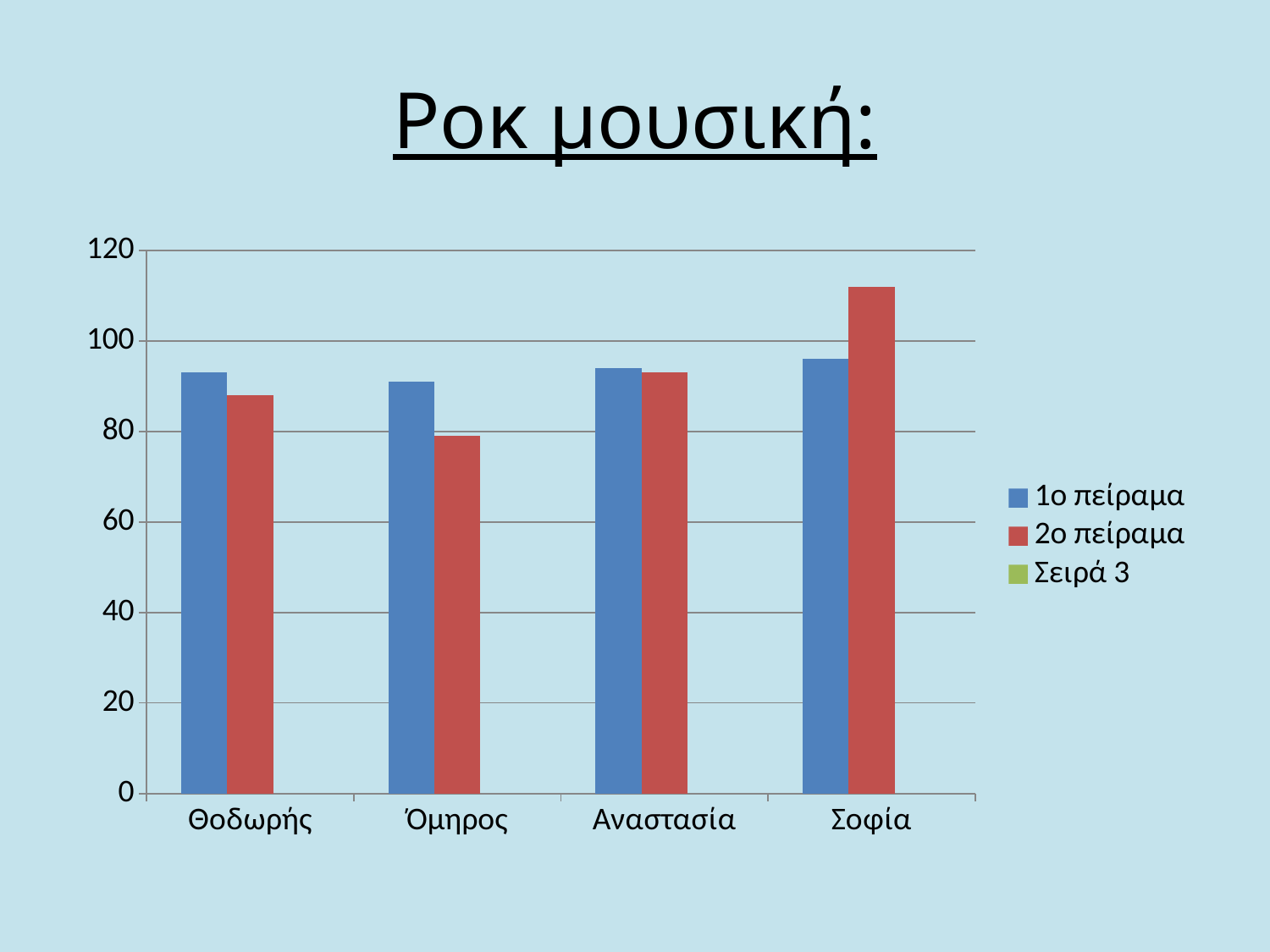
How many series does the legend list? 3 For Όμηρος, which is larger: 1ο πείραμα or 2ο πείραμα? 1ο πείραμα What is the title of the chart? Ροκ μουσική: Which category has the lowest value for 2ο πείραμα? Όμηρος What is the name of the third series in the legend? Σειρά 3 Is the 2ο πείραμα value for Σοφία greater or less than 100? greater How many categories are shown on the x axis? 4 Is the 1ο πείραμα value for Αναστασία greater or less than 100? less Which category has the highest value for 2ο πείραμα? Σοφία Is the 2ο πείραμα value for Όμηρος greater or less than 60? greater For Σοφία, which is larger: 1ο πείραμα or 2ο πείραμα? 2ο πείραμα What kind of chart is shown on the slide? bar chart